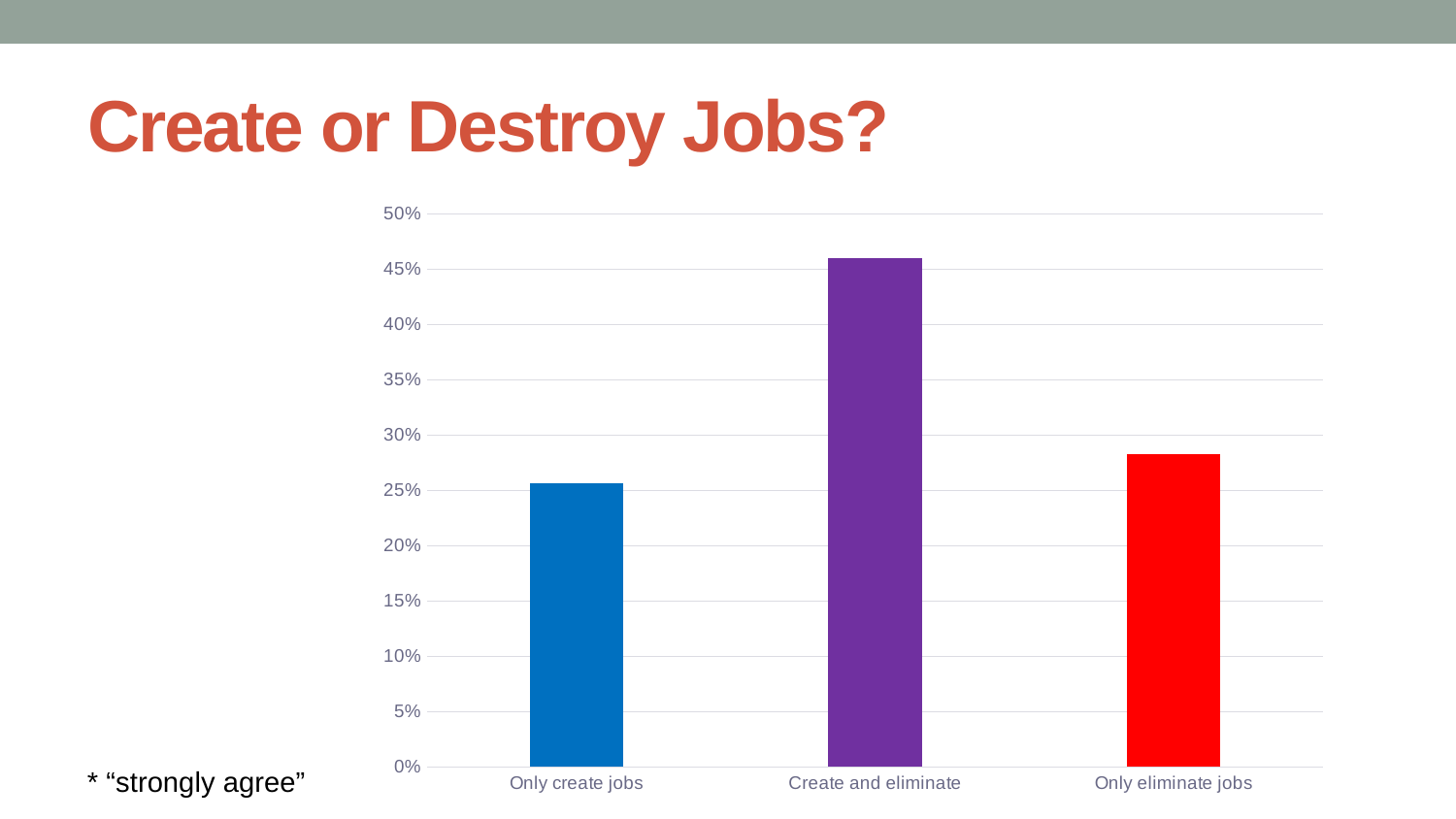
What colour is the bar for Create and eliminate? purple How many categories are shown on the x axis of the chart? 3 Is the value for Only create jobs greater or less than 30%? less What is the title of the slide containing the chart? Create or Destroy Jobs? Which is larger, the value for Only eliminate jobs or the value for Only create jobs? Only eliminate jobs Is the value for Only create jobs greater or less than 20%? greater Is the value for Create and eliminate greater or less than 40%? greater Which category has the lowest value in the chart? Only create jobs Which category has the highest value in the chart? Create and eliminate What kind of chart is shown on the slide? bar chart